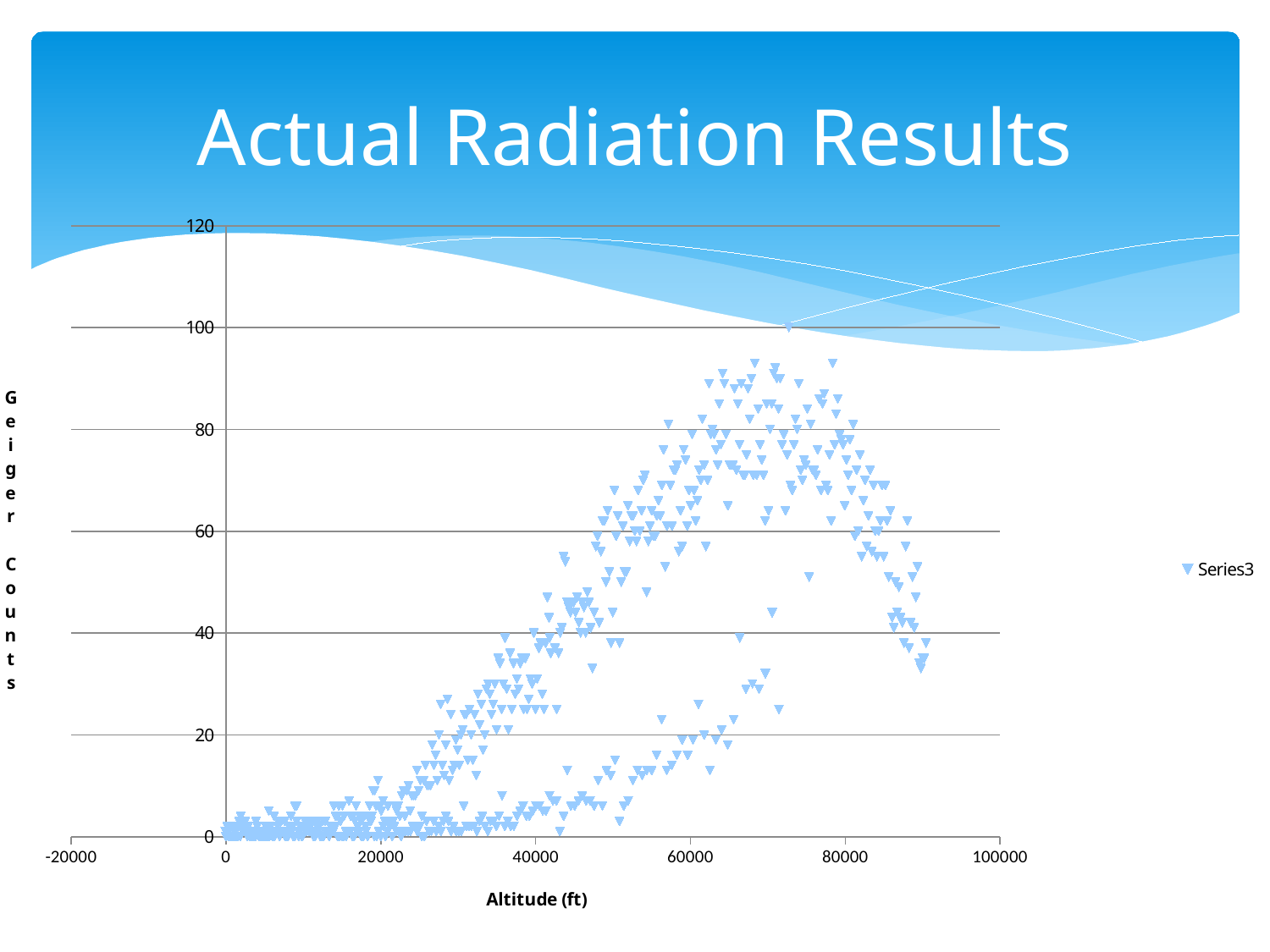
Is the highest Geiger count plotted greater or less than 80? greater What kind of chart is shown on the slide? scatter chart Are the Geiger counts at an altitude of 10000 ft greater or less than 20? less Do the Geiger counts generally rise or fall as altitude increases from 0 to 60000 ft? rise What is the highest value shown on the y axis? 120 Do the Geiger counts generally rise or fall as altitude increases from 80000 to 90000 ft? fall How many series does the legend list? 1 What is the title of the chart? Actual Radiation Results What is the label of the x axis? Altitude (ft) Are the Geiger counts at an altitude of 90000 ft greater or less than 60? less